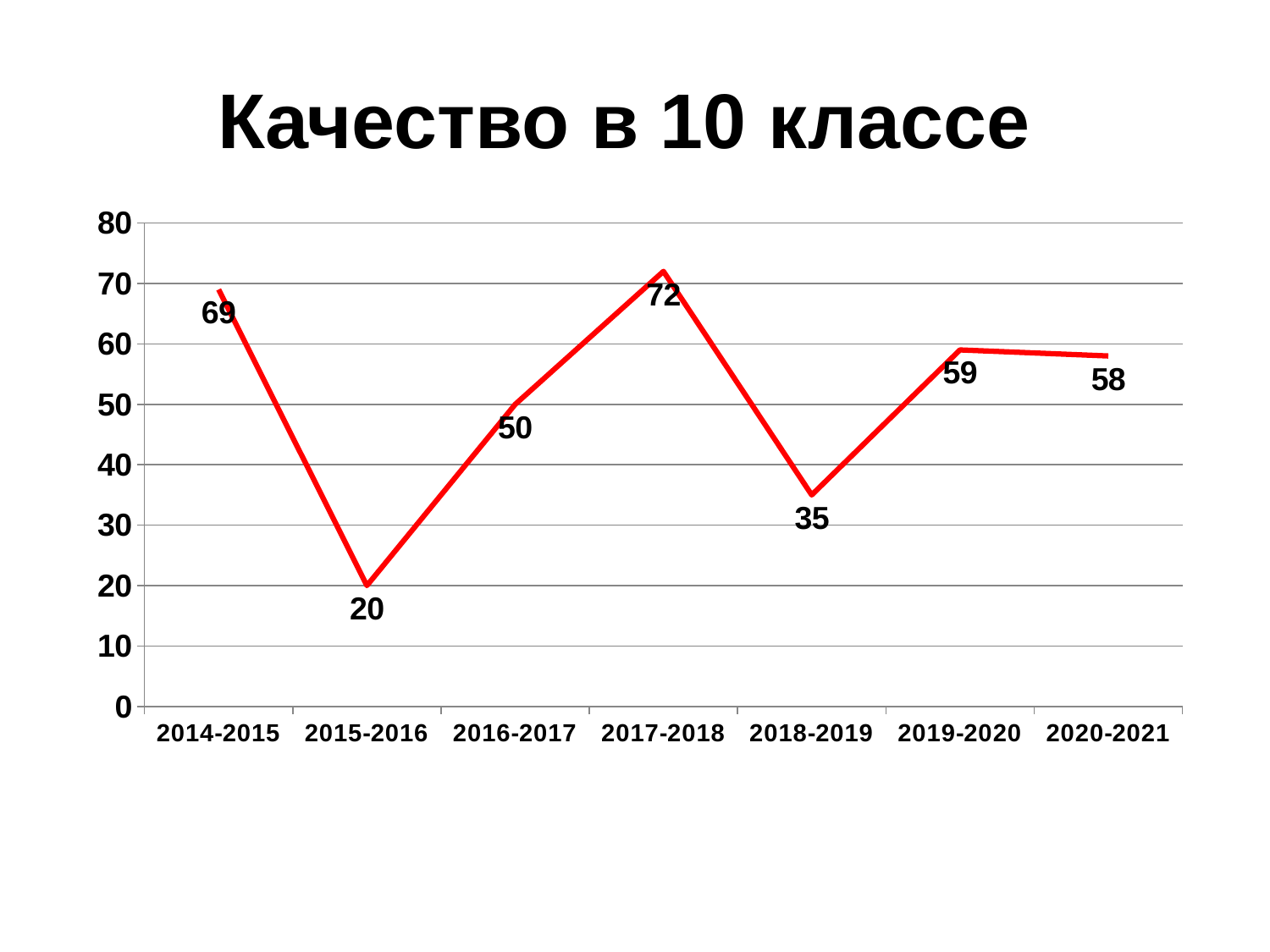
How many years are plotted on the chart? 7 What is the difference between the values for 2014-2015 and 2015-2016? 49 What is the value for 2014-2015? 69 Does the value rise or fall from 2019-2020 to 2020-2021? fall Which year has the highest value? 2017-2018 Which is larger, the value for 2016-2017 or the value for 2019-2020? 2019-2020 What is the value for 2020-2021? 58 Which year has the lowest value? 2015-2016 What is the value for 2018-2019? 35 What is the title of the chart? Качество в 10 классе What kind of chart is shown? line chart What is the difference between the values for 2017-2018 and 2018-2019? 37